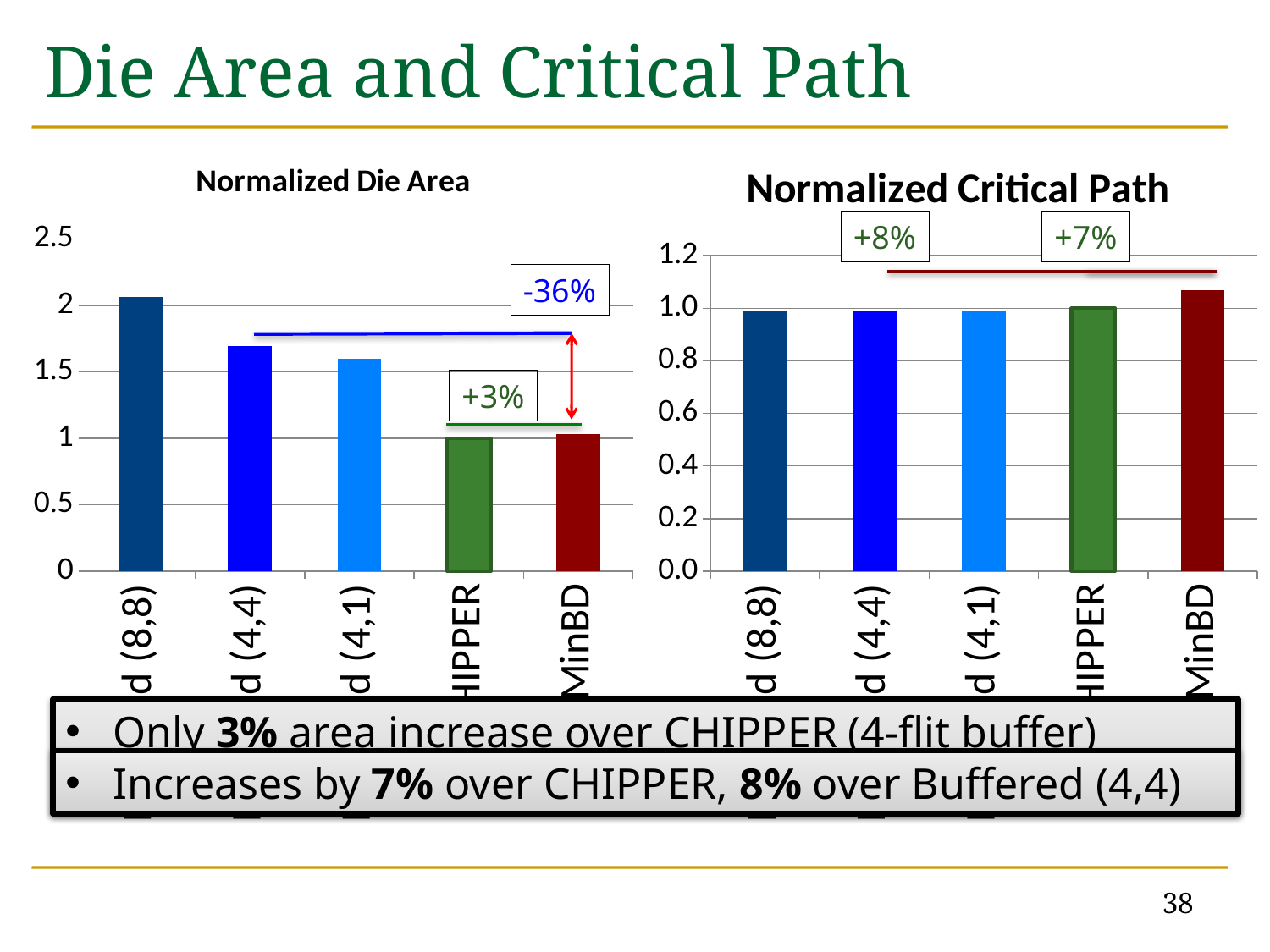
In the Normalized Die Area chart, is the value for the (4,4) category greater or less than 1? greater In the Normalized Die Area chart, which category has the highest bar? (8,8) In the Normalized Die Area chart, is the value for the (8,8) category greater or less than 1.5? greater In the Normalized Critical Path chart, is the value for MinBD greater or less than 1.0? greater In the Normalized Die Area chart, which is larger: the bar for (8,8) or the bar for MinBD? (8,8) What kind of chart is the Normalized Die Area chart? bar chart In the Normalized Critical Path chart, which category has the highest bar? MinBD How many bars are plotted in the Normalized Critical Path chart? 5 What percentage change is annotated in the blue label on the Normalized Die Area chart? -36% What is the title of the chart on the right side of the slide? Normalized Critical Path